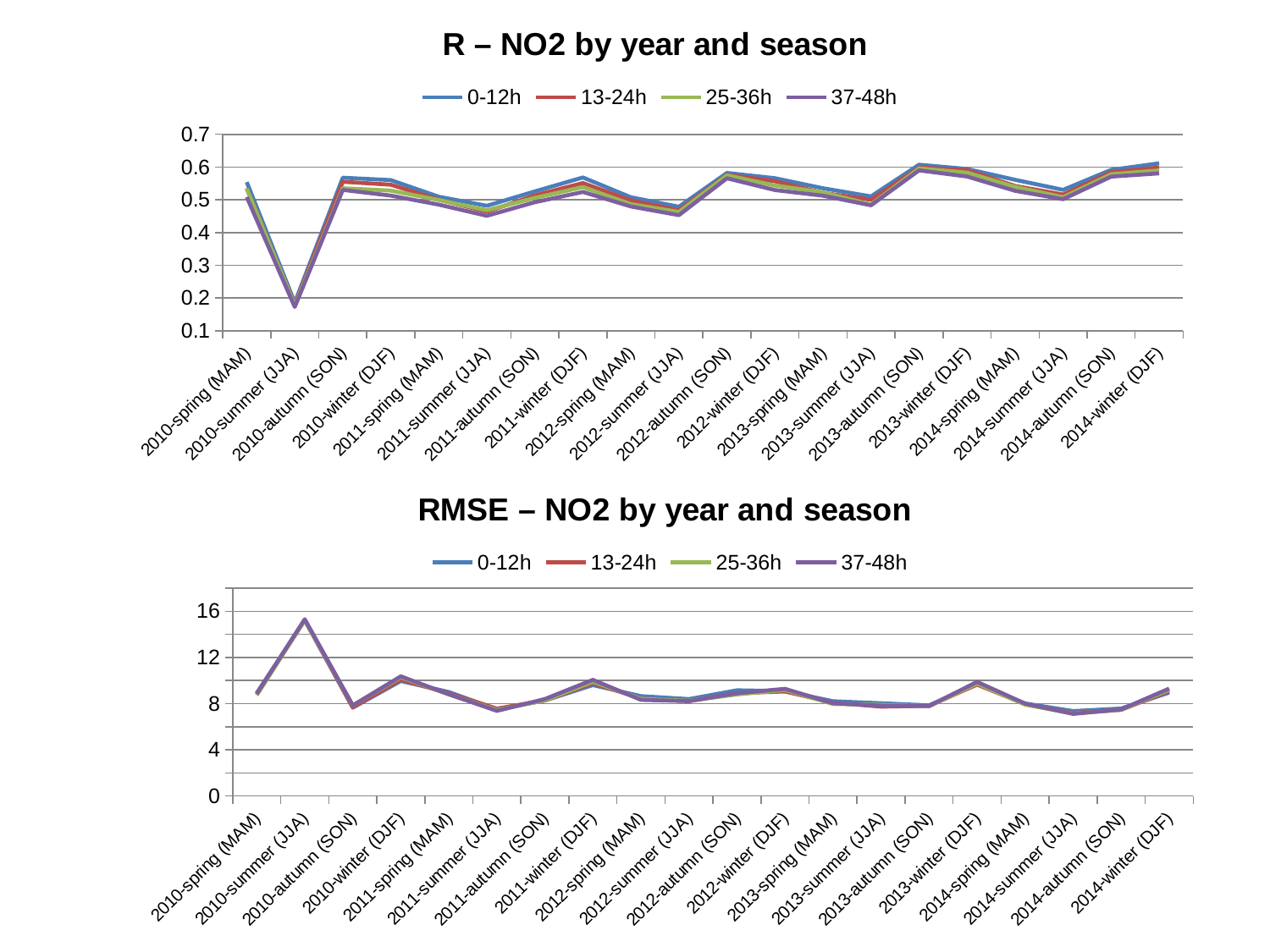
In the 'RMSE – NO2 by year and season' chart, is the value for 2010-summer (JJA) greater or less than 12? greater In the 'R – NO2 by year and season' chart, is the value for 2010-summer (JJA) greater or less than 0.3? less In the 'R – NO2 by year and season' chart, which category has the lowest values? 2010-summer (JJA) In the 'RMSE – NO2 by year and season' chart, is the value for 2014-summer (JJA) greater or less than 8? less What is the title of the top chart on the slide? R – NO2 by year and season How many year-season categories are shown on the x axis of the 'R – NO2 by year and season' chart? 20 In the 'RMSE – NO2 by year and season' chart, which category has the highest values? 2010-summer (JJA) What kind of chart is the 'R – NO2 by year and season' chart? line chart How many series does the legend of the 'RMSE – NO2 by year and season' chart list? 4 In the 'RMSE – NO2 by year and season' chart, which is larger: the value for 2010-summer (JJA) or the value for 2010-autumn (SON)? 2010-summer (JJA) Which series is shown in purple in the 'R – NO2 by year and season' chart legend? 37-48h